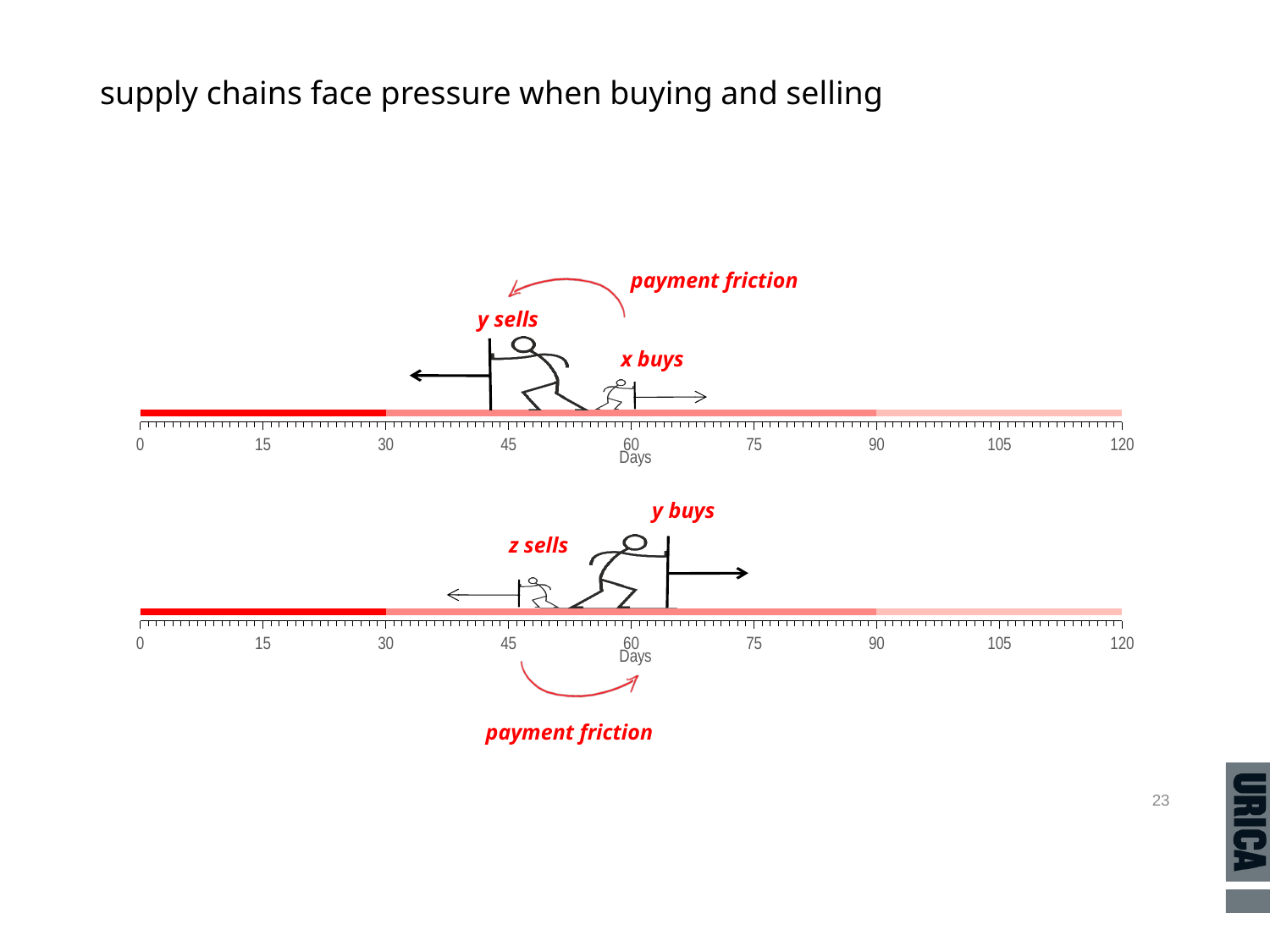
On the top timeline, is the point where 'x buys' is marked greater or less than 45 days? greater What is the interval between labelled tick marks on the Days axis of the top timeline? 15 On the top timeline, at what day value does the darkest red segment of the bar end? 30 On the bottom timeline, at what day value does the darkest red segment of the bar end? 30 On the bottom timeline, is the point where 'z sells' is marked greater or less than 30 days? greater How many labelled tick values are shown on the Days axis of the bottom timeline? 9 How many timeline charts are shown on the slide? 2 What is the highest value marked on the Days axis of the bottom timeline? 120 What is the label of the horizontal axis on the top timeline? Days On the top timeline, is the point where 'y sells' is marked greater or less than 75 days? less